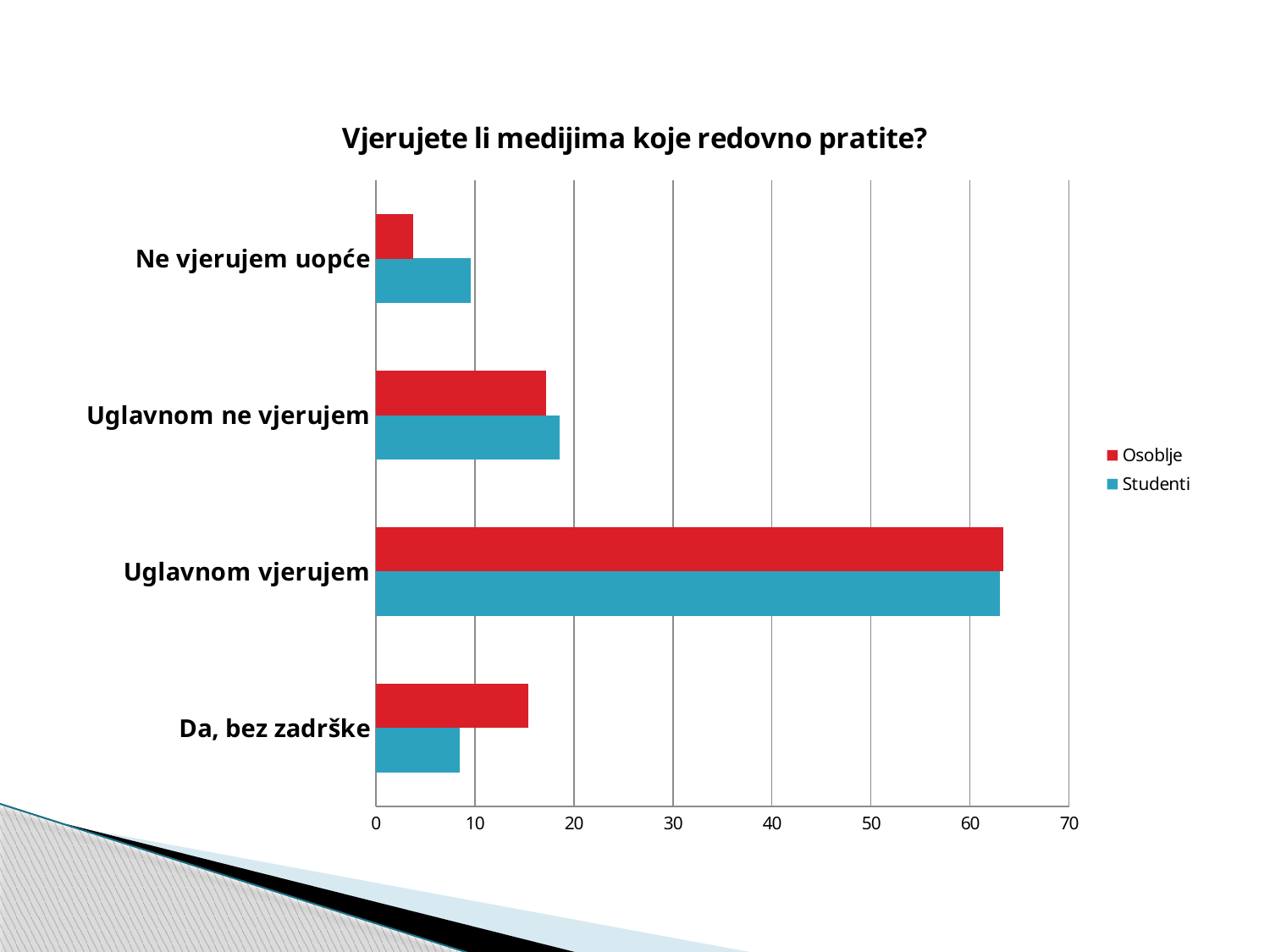
For 'Da, bez zadrške', which series has the larger value, Osoblje or Studenti? Osoblje How many series does the legend list? 2 Which colour represents the Studenti series in the legend? blue For 'Ne vjerujem uopće', which series has the larger value, Osoblje or Studenti? Studenti What kind of chart is shown on the slide? bar chart How many categories are shown on the chart? 4 Which category has the lowest value for Osoblje? Ne vjerujem uopće Which category has the highest value for Studenti? Uglavnom vjerujem Is the value for Osoblje in 'Uglavnom vjerujem' greater or less than 60? greater What is the title of the chart? Vjerujete li medijima koje redovno pratite? Which category has the highest value for Osoblje? Uglavnom vjerujem Is the value for Studenti in 'Uglavnom ne vjerujem' greater or less than 20? less